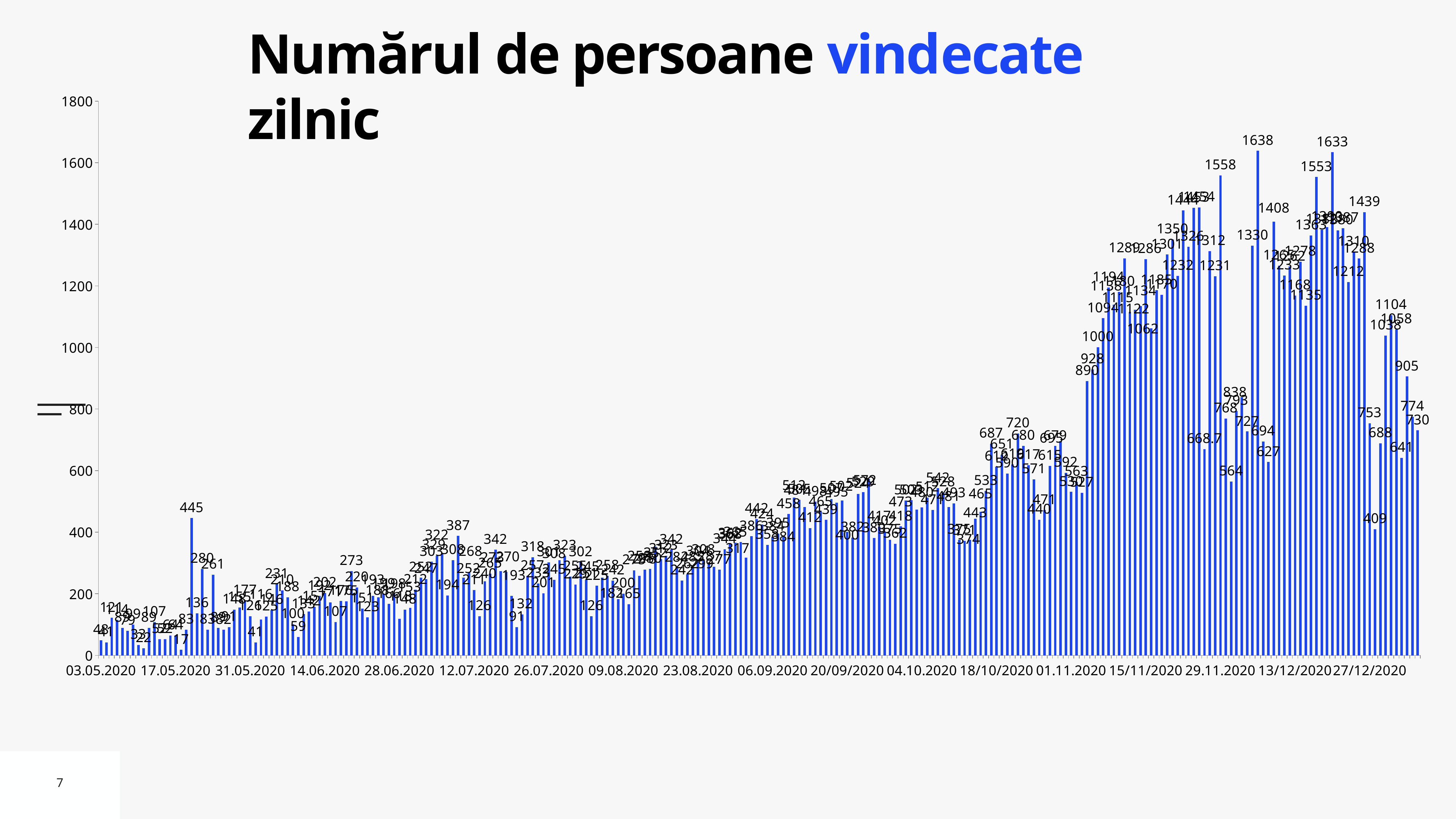
Is the value of the tallest bar in May 2020 (labelled 445) greater or less than 400? greater What is the value of the rightmost bar on the chart? 730 What is the difference between the two tallest bars, labelled 1638 and 1633? 5 Overall, do the values rise or fall from 03.05.2020 to the end of December 2020? rise What is the value of the tallest bar in the May 2020 section of the chart (between 17.05.2020 and 31.05.2020)? 445 What is the highest value shown on the chart? 1638 What is the difference between the bars labelled 905 and 774 near the end of the chart? 131 What kind of chart is shown on the slide? bar chart What is the maximum value shown on the vertical axis? 1800 Is the bar labelled 1408 greater or less than 1400? greater What is the title of the chart? Numărul de persoane vindecate zilnic Which is larger, the bar labelled 1558 or the bar labelled 1439? 1558